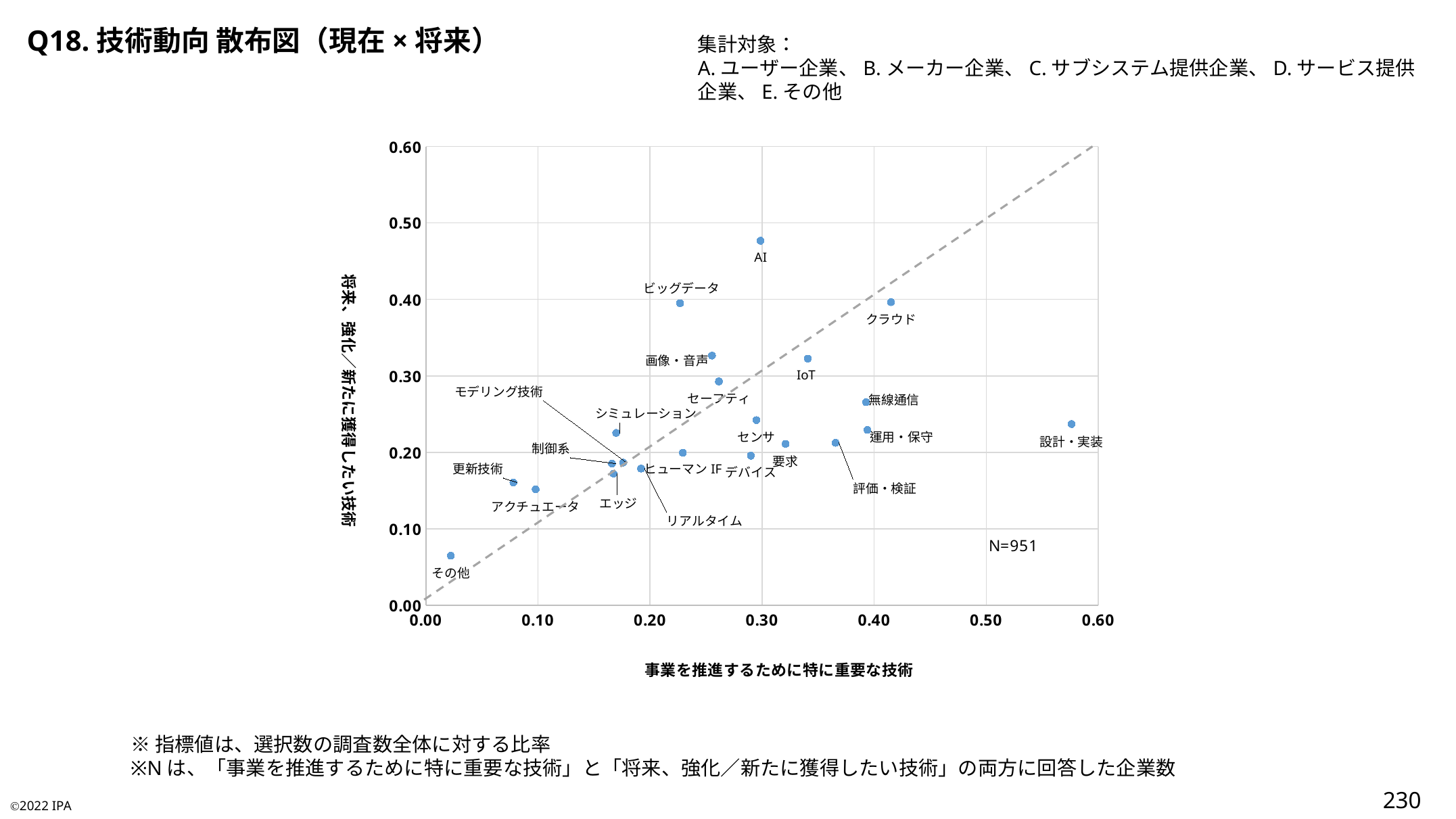
Which has the larger horizontal-axis value, 設計・実装 or 無線通信? 設計・実装 Is the vertical-axis value for AI greater or less than 0.40? greater Is the horizontal-axis value for その他 greater or less than 0.10? less Which point has the lowest value on the vertical axis? その他 Is the vertical-axis value for 更新技術 greater or less than 0.20? less Which technology has the highest value on the vertical axis (将来、強化／新たに獲得したい技術)? AI What kind of chart is shown on the slide? scatter chart Which has the higher vertical-axis value, AI or クラウド? AI Which technology has the highest value on the horizontal axis (事業を推進するために特に重要な技術)? 設計・実装 What is the N value shown on the chart? N=951